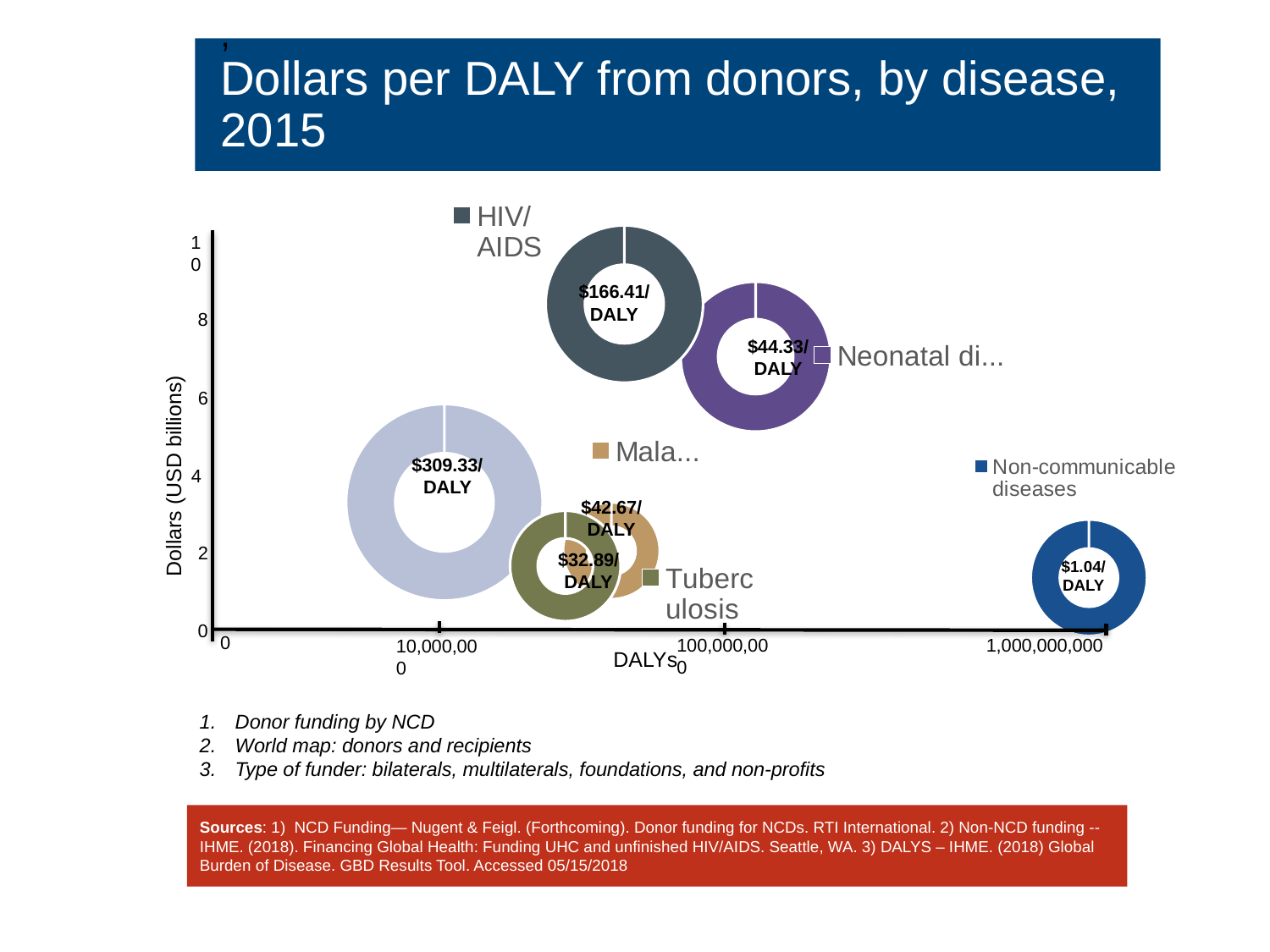
What is the dollars per DALY value shown for Non-communicable diseases? $1.04/DALY What is the dollars per DALY value shown for Tuberculosis? $32.89/DALY What is the dollars per DALY value shown for HIV/AIDS? $166.41/DALY What is the title of the vertical axis? Dollars (USD billions) What kind of chart is shown on the slide? Bubble chart What is the difference in dollars per DALY between HIV/AIDS and the Neonatal bubble? $122.08/DALY What is the dollars per DALY value shown for the Neonatal bubble? $44.33/DALY Is the HIV/AIDS bubble positioned at more or less than 6 on the Dollars (USD billions) axis? greater Which has a higher dollars per DALY value, HIV/AIDS or Tuberculosis? HIV/AIDS Which labelled disease has the lowest dollars per DALY value? Non-communicable diseases Is the Non-communicable diseases bubble positioned at more or less than 100,000,000 on the DALYs axis? greater How many bubbles are plotted on the chart? 6